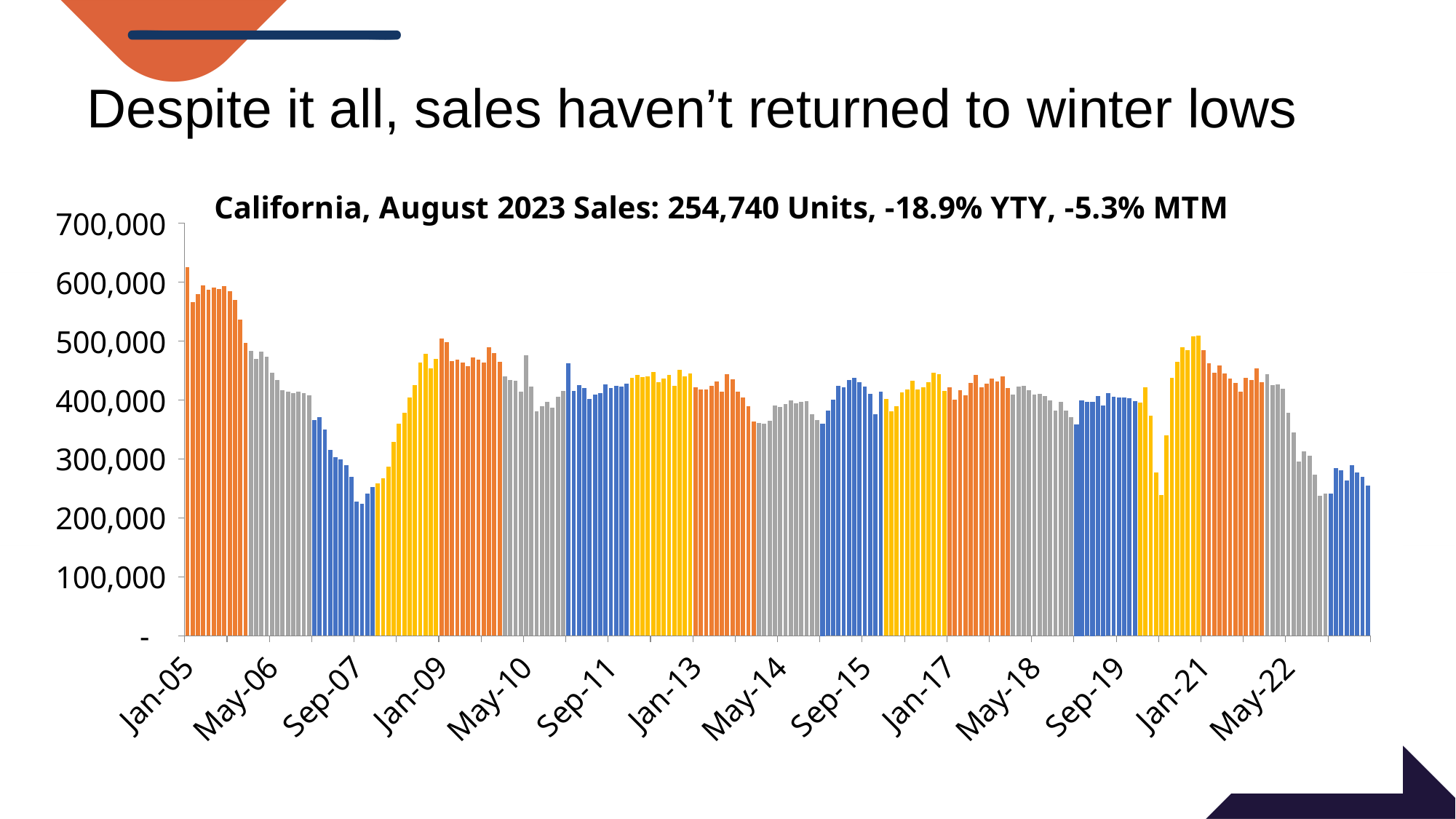
Which is larger, the value for Jan-05 or the value for the last bar (August 2023)? Jan-05 What kind of chart is shown on the slide? bar chart What is the year-to-year (YTY) change in sales stated in the chart title? -18.9% What is the month-to-month (MTM) change in sales stated in the chart title? -5.3% What is the title of the chart? California, August 2023 Sales: 254,740 Units, -18.9% YTY, -5.3% MTM How many units were sold in California in August 2023 according to the chart title? 254,740 Units Is the value for Jan-05 greater or less than 600,000? greater Is the value for Jan-09 greater or less than 400,000? greater Is the value for Jan-21 greater or less than 400,000? greater Which month has the highest bar in the chart? Jan-05 Do the values generally rise or fall from Jan-21 to the end of the chart? fall